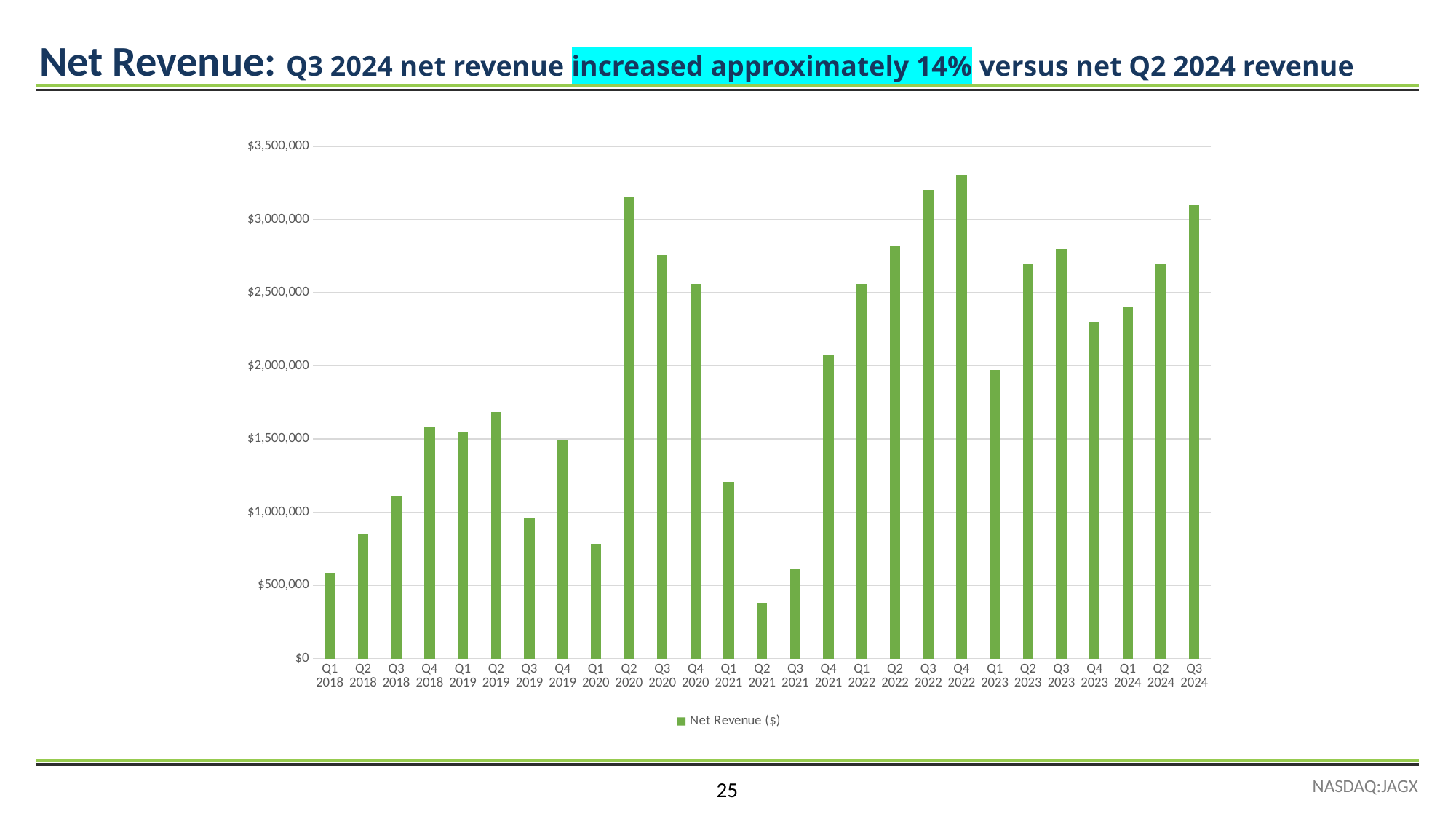
How many series does the legend list? 1 Is the net revenue for Q2 2020 greater or less than $3,000,000? greater Do the net revenue values rise or fall across the four quarters of 2018? rise Is the net revenue for Q4 2023 greater or less than $2,500,000? less Which quarter has the highest net revenue? Q4 2022 What kind of chart is shown on the slide? bar chart Which is larger, the net revenue for Q2 2024 or Q3 2024? Q3 2024 Is the net revenue for Q2 2021 greater or less than $500,000? less How many quarters are plotted on the x axis of the Net Revenue chart? 27 What is the legend entry for the series in the chart? Net Revenue ($) Which quarter has the lowest net revenue? Q2 2021